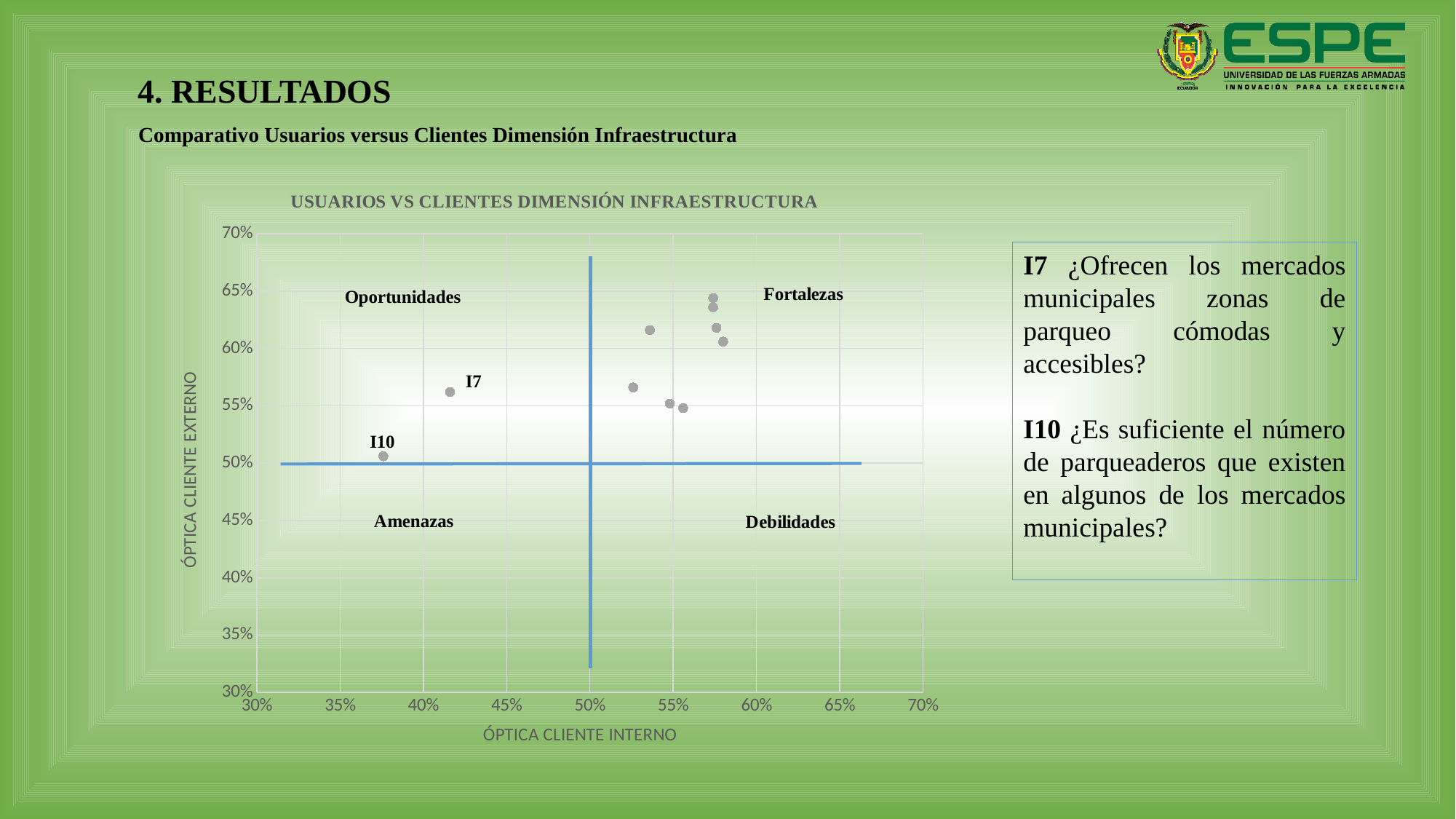
Is the ÓPTICA CLIENTE INTERNO value for point I7 greater or less than 45%? less What is the title of the chart? USUARIOS VS CLIENTES DIMENSIÓN INFRAESTRUCTURA Which quadrant label appears in the upper-right area of the chart? Fortalezas Is the ÓPTICA CLIENTE EXTERNO value for point I7 greater or less than 50%? greater Is the ÓPTICA CLIENTE INTERNO value for point I10 greater or less than 40%? less Which labelled point has the lower ÓPTICA CLIENTE INTERNO value, I7 or I10? I10 What kind of chart is shown on the slide? scatter chart In which quadrant of the chart does point I7 lie? Oportunidades Which labelled point has the higher ÓPTICA CLIENTE EXTERNO value, I7 or I10? I7 What is the highest value shown on the vertical axis? 70%